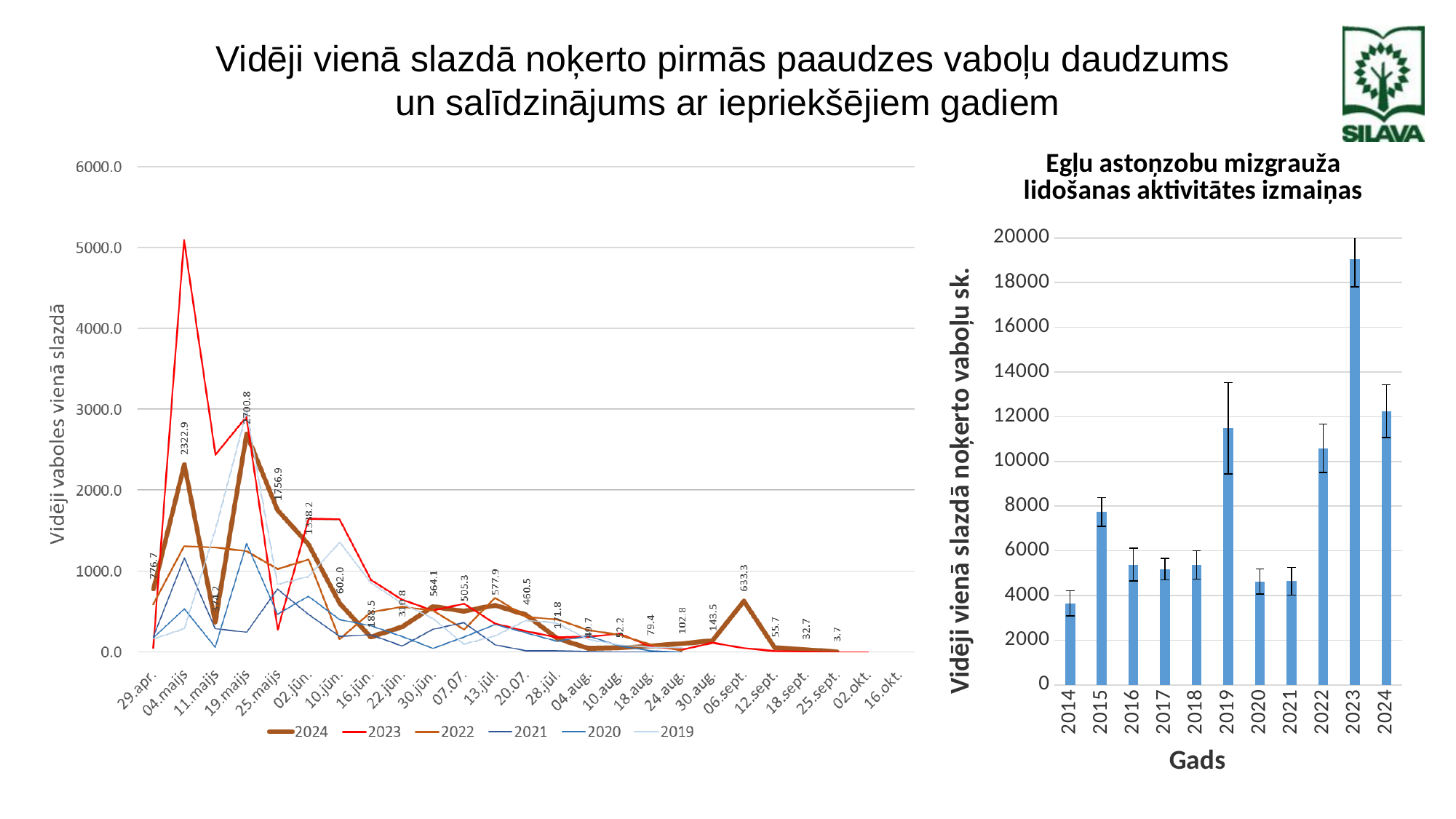
On the right-hand bar chart, which is larger, the value for 2015 or the value for 2016? 2015 On the left-hand line chart, which series reaches the highest peak of all? 2023 On the right-hand bar chart, is the value for 2019 greater or less than 10000? greater On the right-hand bar chart, is the value for 2014 greater or less than 4000? less On the left-hand line chart, how many series does the legend list? 6 On the right-hand bar chart, how many years are shown on the x axis? 11 On the right-hand bar chart, which year has the lowest value? 2014 On the right-hand bar chart, is the value for 2023 greater or less than 18000? greater On the right-hand bar chart (Egļu astoņzobu mizgrauža lidošanas aktivitātes izmaiņas), which year has the highest value? 2023 On the left-hand line chart, what is the value of the 2024 series at 19.maijs? 2700.8 On the left-hand line chart, what is the difference between the 2024 values at 19.maijs and 04.maijs? 377.9 On the left-hand line chart, what is the value of the 2024 series at 06.sept.? 633.3